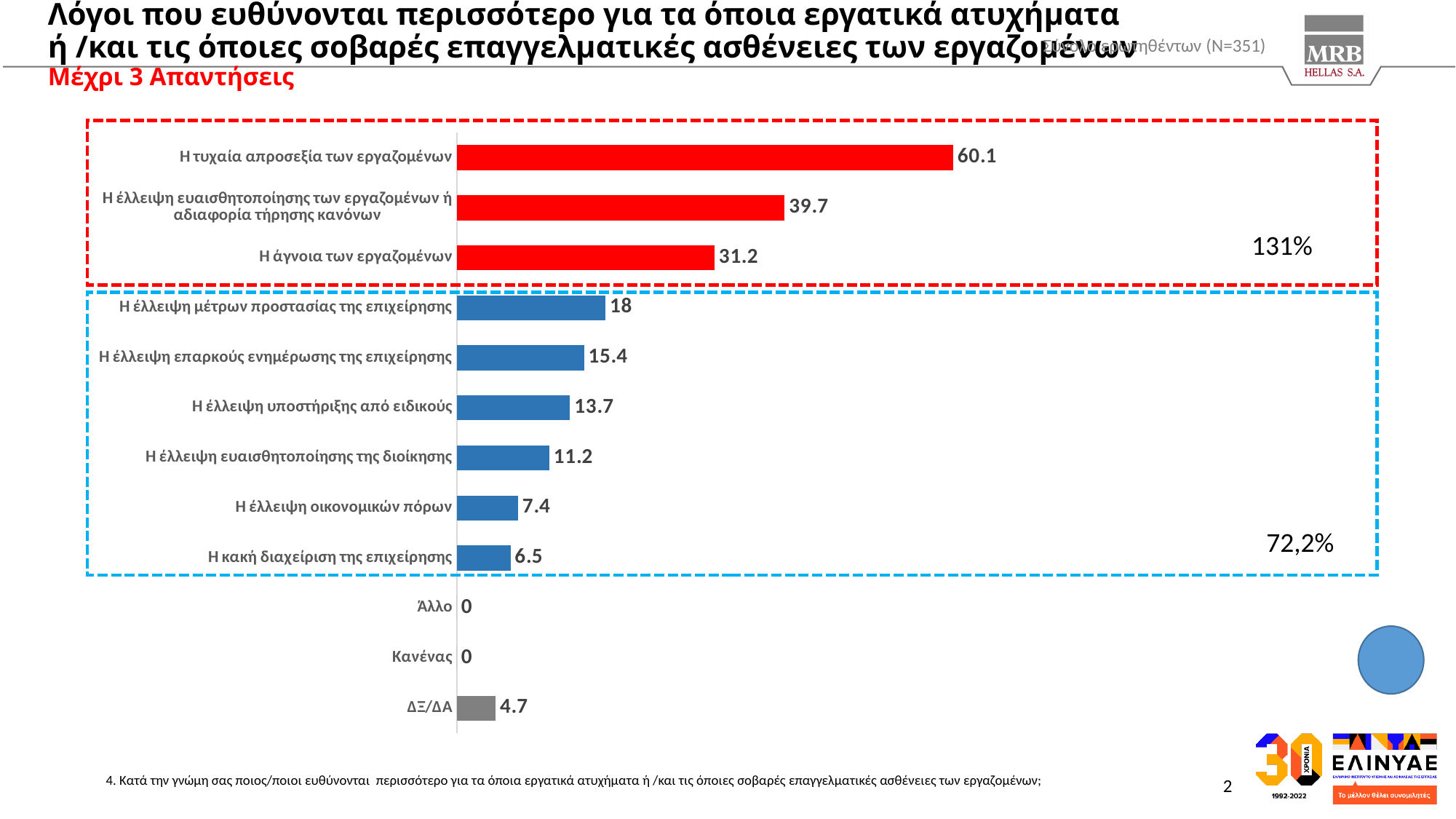
What is the value for "Η τυχαία απροσεξία των εργαζομένων"? 60.1 What kind of chart is shown on the slide? Bar chart Which category has the lowest non-zero value? ΔΞ/ΔΑ What is the value for "Η έλλειψη οικονομικών πόρων"? 7.4 What is the value for "Η έλλειψη μέτρων προστασίας της επιχείρησης"? 18 What percentage is shown next to the red dashed box? 131% How many categories are shown in the chart? 12 What is the difference between the values for "Η τυχαία απροσεξία των εργαζομένων" and "Η έλλειψη ευαισθητοποίησης των εργαζομένων ή αδιαφορία τήρησης κανόνων"? 20.4 What is the value for "ΔΞ/ΔΑ"? 4.7 Which is larger: the value for "Η έλλειψη επαρκούς ενημέρωσης της επιχείρησης" or "Η έλλειψη υποστήριξης από ειδικούς"? Η έλλειψη επαρκούς ενημέρωσης της επιχείρησης Which category has the highest value? Η τυχαία απροσεξία των εργαζομένων What is the value for "Η άγνοια των εργαζομένων"? 31.2